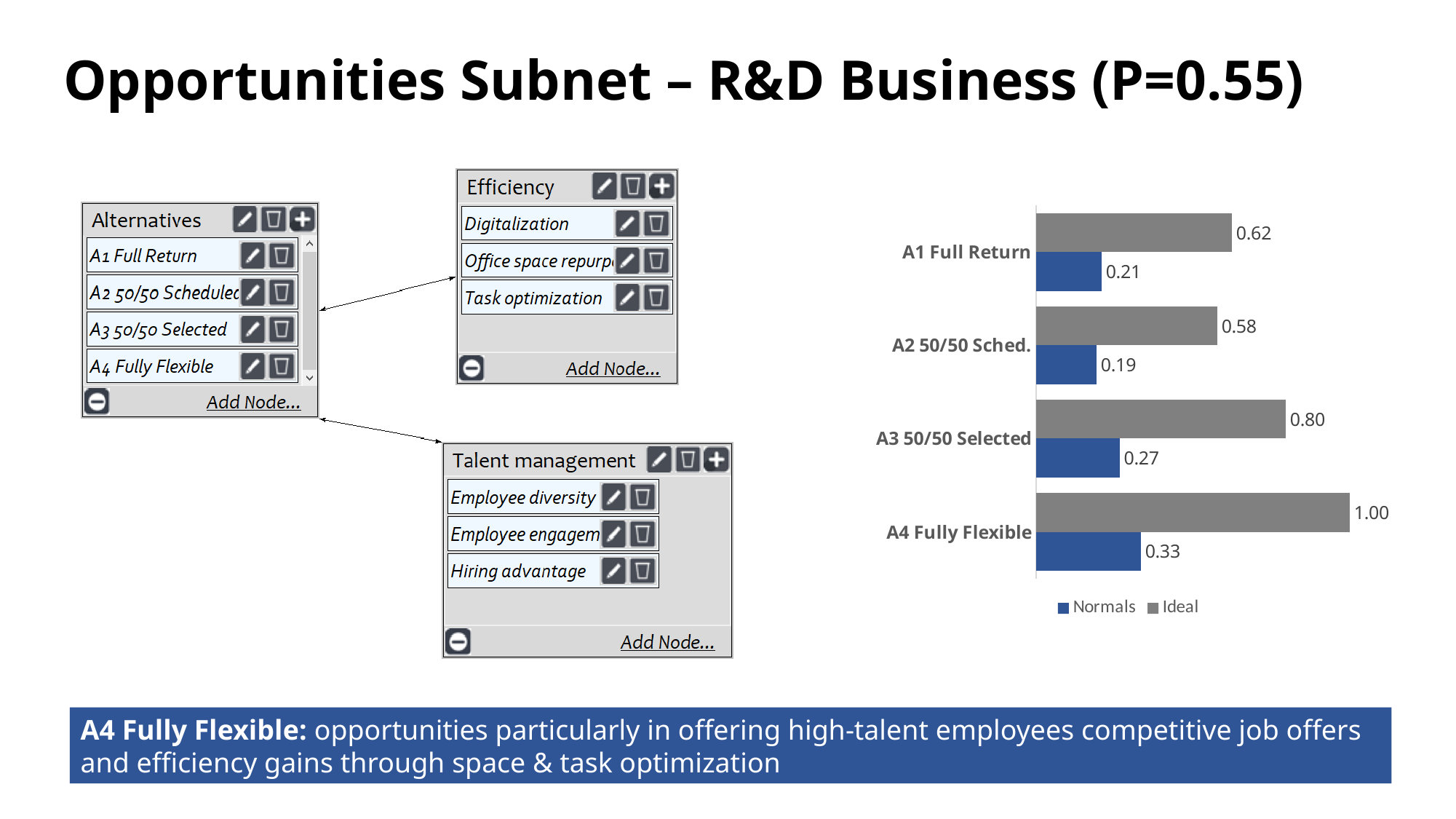
What kind of chart is shown on the slide? Bar chart Which alternative has the lowest Ideal value? A2 50/50 Sched. What is the Ideal value for A2 50/50 Sched.? 0.58 Which alternative has the highest Normals value? A4 Fully Flexible What is the Ideal value for A4 Fully Flexible? 1.00 What is the Normals value for A3 50/50 Selected? 0.27 What is the Normals value for A1 Full Return? 0.21 How many series does the chart legend list? 2 How many alternatives are plotted in the chart? 4 What is the difference between the Ideal values for A3 50/50 Selected and A1 Full Return? 0.18 Which colour represents the Ideal series in the chart? Grey Which is larger, the Normals value for A2 50/50 Sched. or for A3 50/50 Selected? A3 50/50 Selected